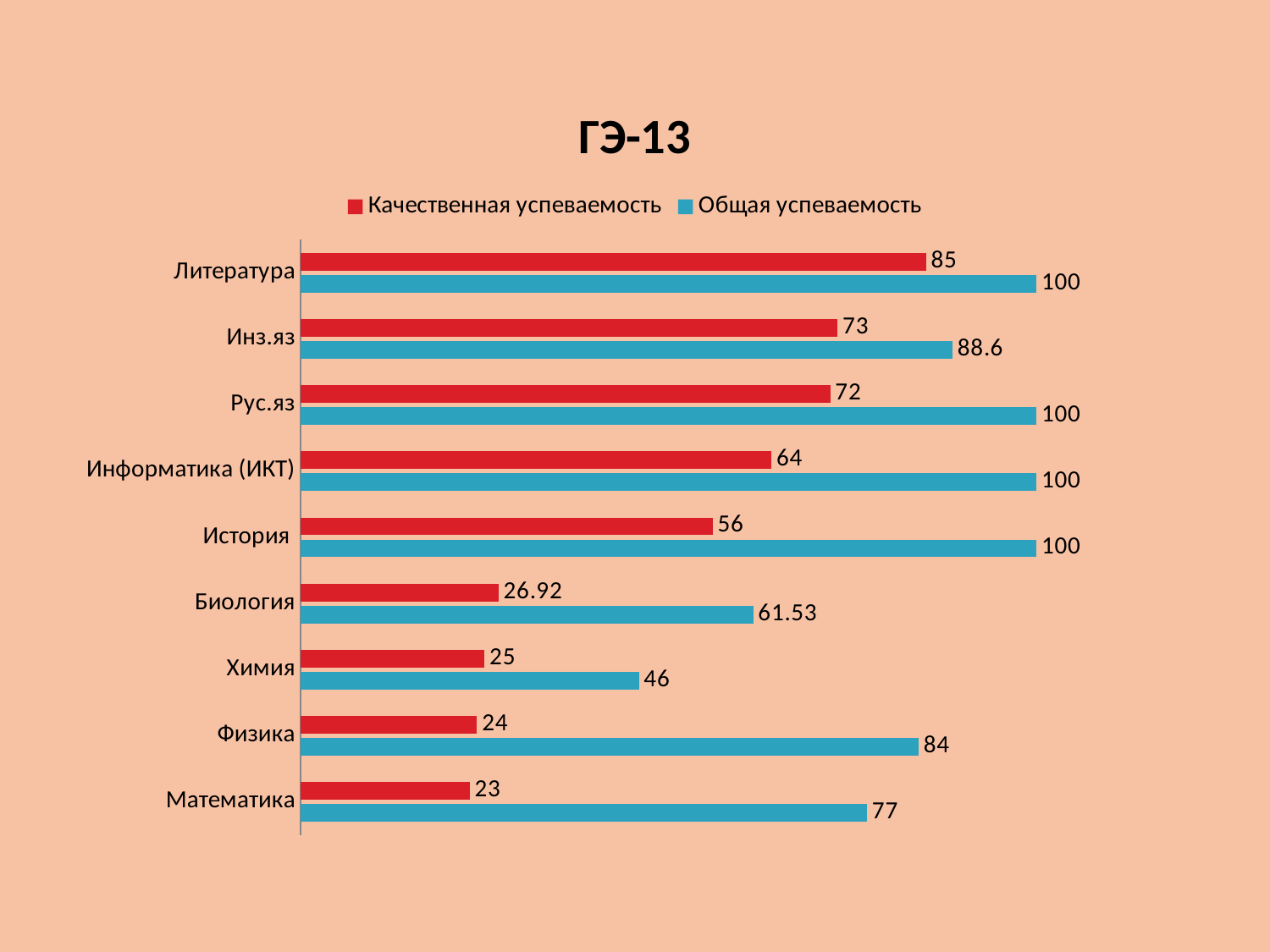
What is the Общая успеваемость value for Биология? 61.53 What kind of chart is shown on the slide? bar chart How many series does the legend list? 2 What is the title of the chart? ГЭ-13 What is the Качественная успеваемость value for Литература? 85 What is the Общая успеваемость value for Инз.яз? 88.6 Which is larger: the Общая успеваемость value for Физика or for Математика? Физика What is the difference between the Общая успеваемость and Качественная успеваемость values for Физика? 60 Which category has the highest Качественная успеваемость value? Литература How many categories are shown on the chart? 9 What is the Качественная успеваемость value for Математика? 23 Which category has the lowest Общая успеваемость value? Химия